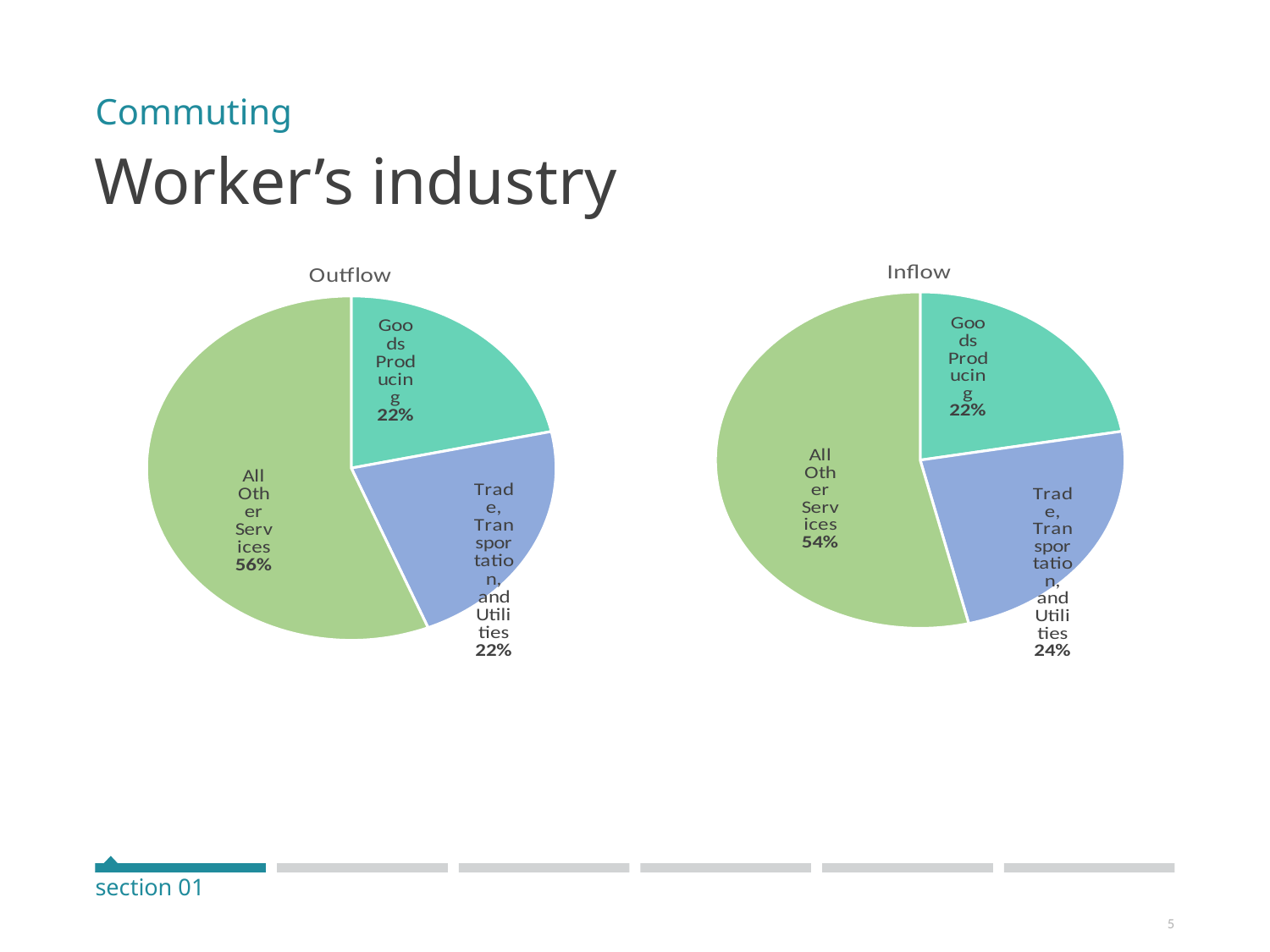
What is the title of the chart on the left? Outflow In the Inflow chart, which is larger: Goods Producing or Trade, Transportation, and Utilities? Trade, Transportation, and Utilities In the Inflow chart, what share does Trade, Transportation, and Utilities have? 24% In the Outflow chart, what share does Goods Producing have? 22% How many categories does the Outflow chart show? 3 In the Outflow chart, what share do All Other Services have? 56% In the Inflow chart, what share do All Other Services have? 54% In the Outflow chart, which category has the largest share? All Other Services What kind of chart is the Inflow chart? Pie chart How many charts are on the slide? 2 In the Inflow chart, which category has the smallest share? Goods Producing What is the difference between the All Other Services share in the Outflow chart and in the Inflow chart? 2 percentage points